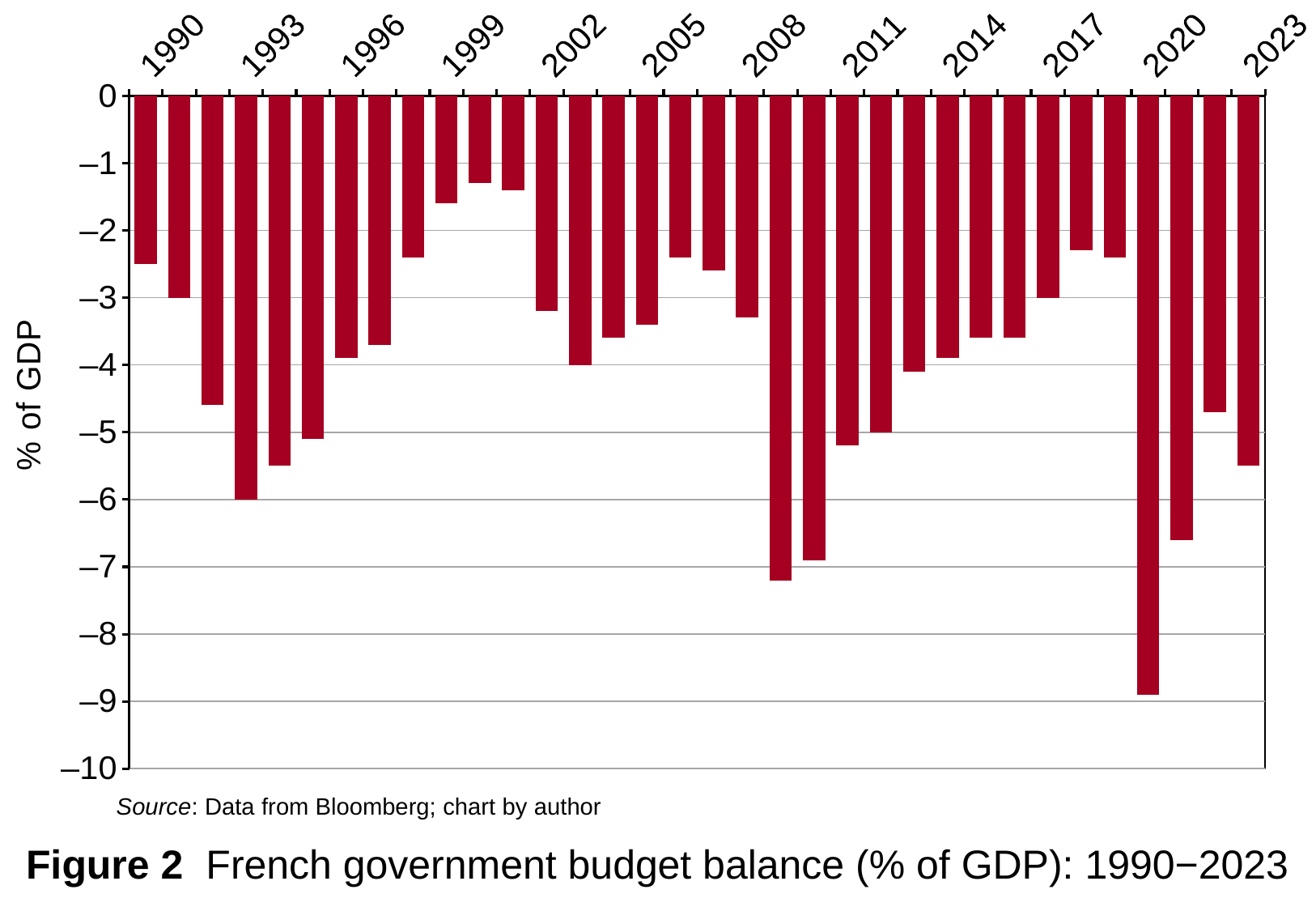
Is the value for 2020 greater or less than −8? less How many years (bars) are plotted in the chart? 34 Which is larger, the value for 2008 or the value for 2011? 2008 What kind of chart is shown on the slide? bar chart Do the values rise or fall from 1993 to 1999? rise Which is larger, the value for 1990 or the value for 1993? 1990 Is the value for 1999 greater or less than −2? greater Is the value for 1993 greater or less than −5? less Which year has the lowest (most negative) budget balance? 2020 What is the label on the vertical axis? % of GDP